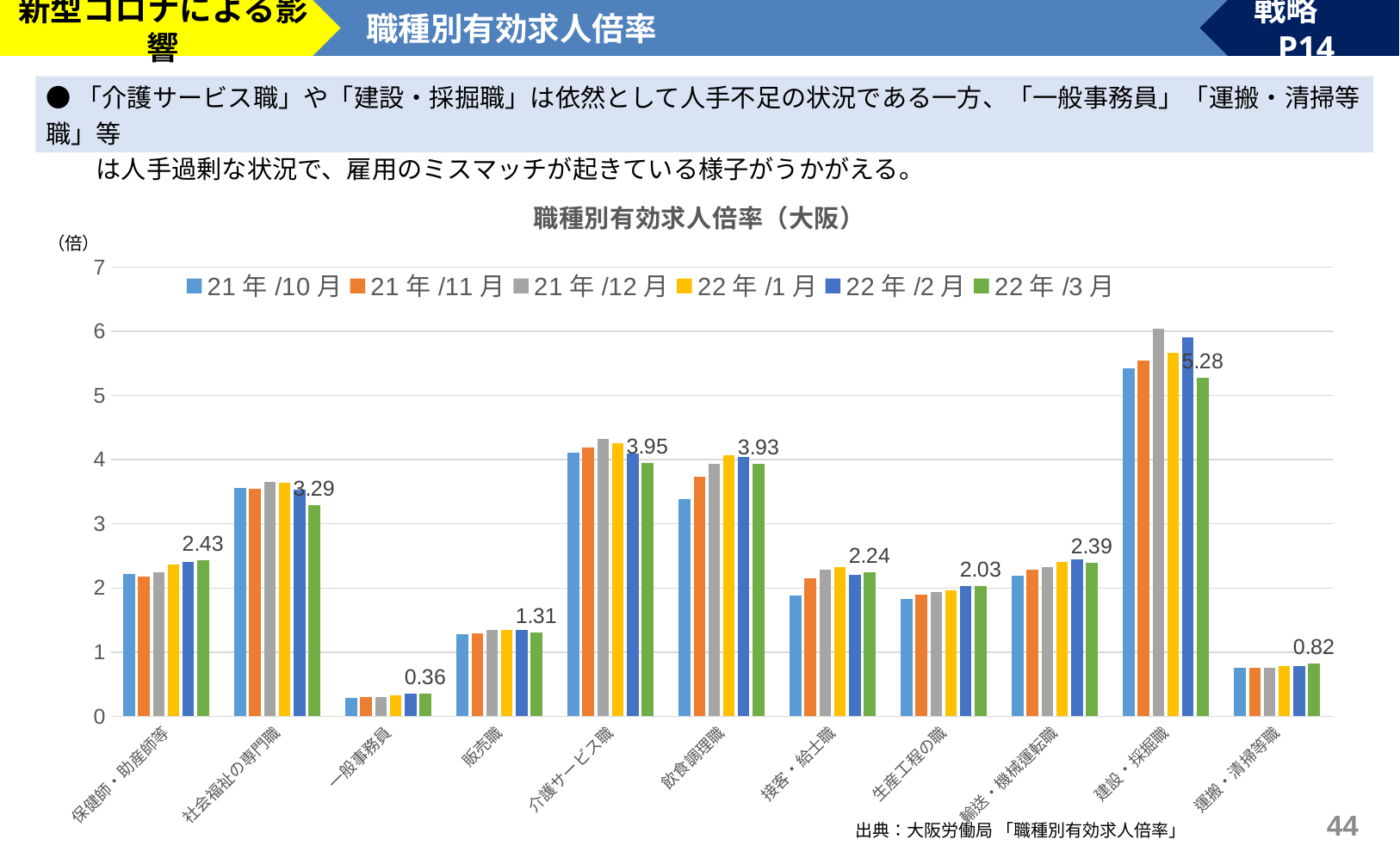
How many occupation categories are shown on the x axis? 11 What is the difference between the 22年/3月 values for 建設・採掘職 and 介護サービス職? 1.33 What is the 22年/3月 value for 介護サービス職? 3.95 How many series does the legend list? 6 What is the 22年/3月 value for 運搬・清掃等職? 0.82 What is the 22年/3月 value for 一般事務員? 0.36 What type of chart is shown on the slide? Bar chart Which occupation has the highest 22年/3月 value? 建設・採掘職 What is the 22年/3月 value for 建設・採掘職? 5.28 Which occupation has the lowest 22年/3月 value? 一般事務員